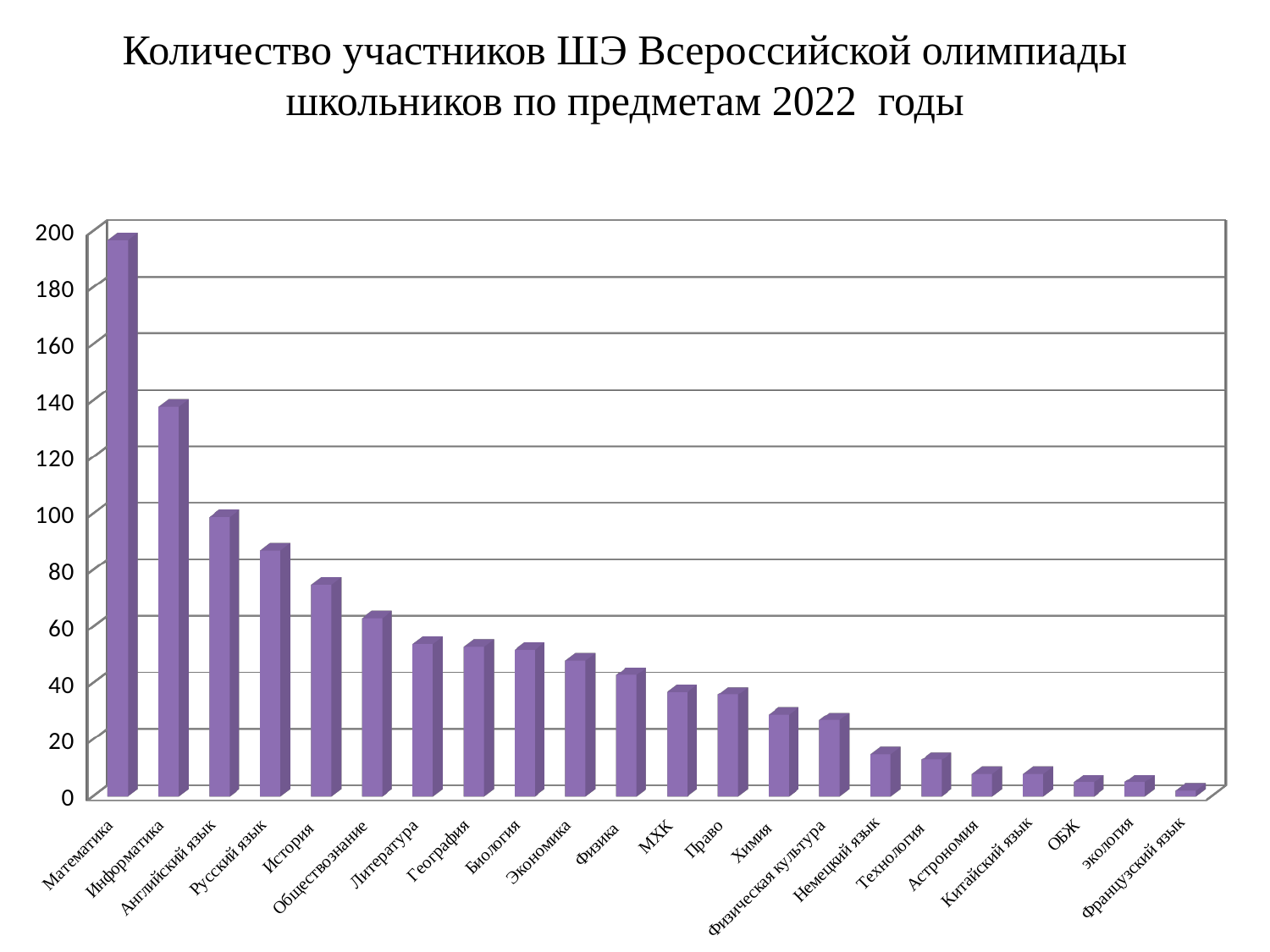
Which subject has the lowest number of participants? Французский язык Is the value for Немецкий язык greater or less than 20? less Is the value for Математика greater or less than 180? greater Which has more participants, Химия or Технология? Химия Do the values rise or fall moving from left to right along the x axis? fall Is the value for Информатика greater or less than 160? less Which subject has the highest number of participants? Математика What kind of chart is shown on the slide? bar chart How many subjects are shown on the x axis? 22 What is the title of the chart? Количество участников ШЭ Всероссийской олимпиады школьников по предметам 2022 годы Which has more participants, Информатика or Английский язык? Информатика